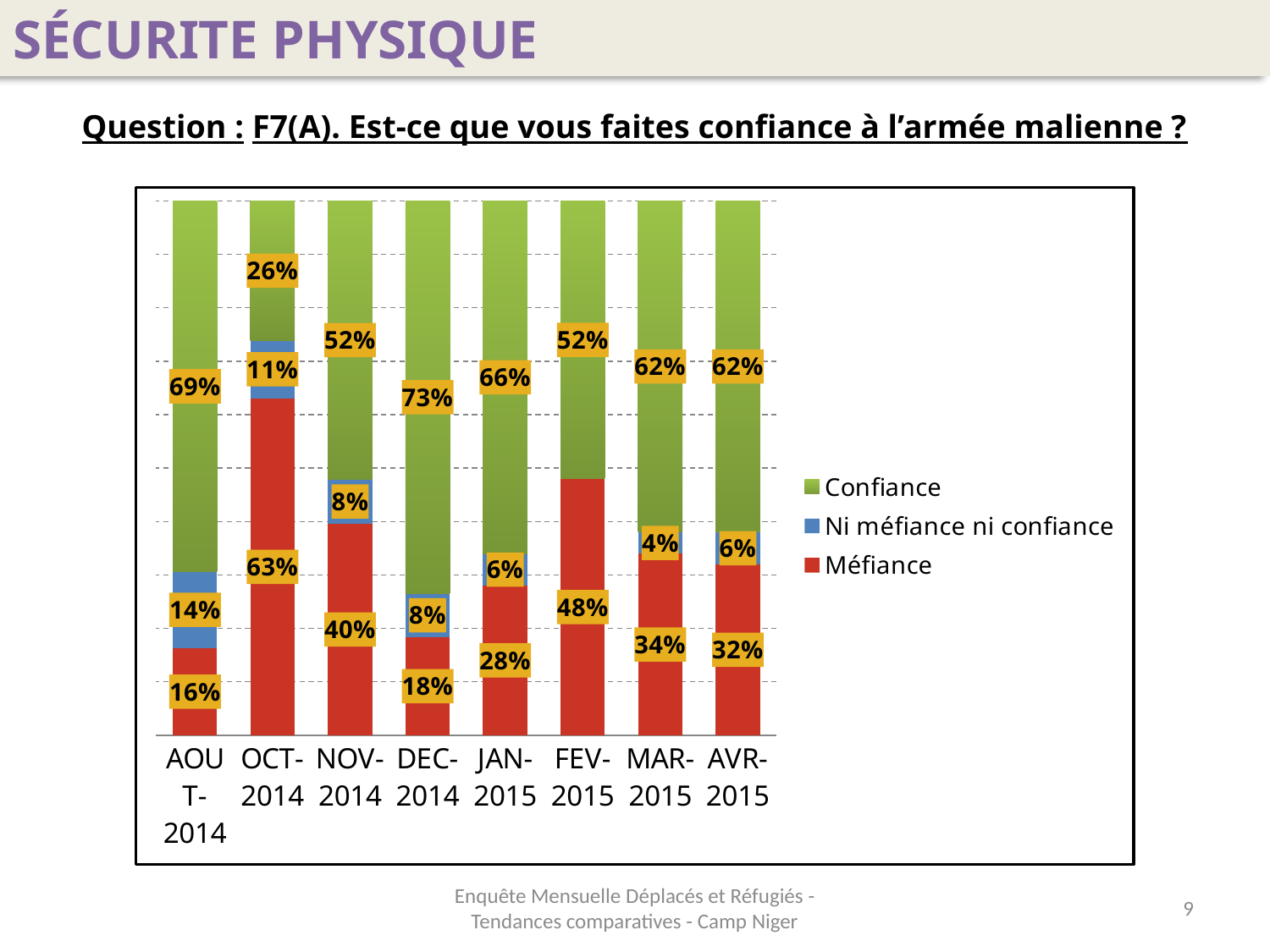
What is the Confiance value for DEC-2014? 73% What kind of chart is shown on the slide? Stacked bar chart How many months are shown on the x axis? 8 What is the Méfiance value for OCT-2014? 63% Which month has the highest Méfiance value? OCT-2014 How many series does the legend list? 3 Which is larger, the Méfiance value for MAR-2015 or for AVR-2015? MAR-2015 Which month has the lowest Confiance value? OCT-2014 What is the difference between the Confiance values for DEC-2014 and NOV-2014? 21% What is the Méfiance value for FEV-2015? 48% Which series is shown in green in the legend? Confiance What is the Ni méfiance ni confiance value for AOUT-2014? 14%